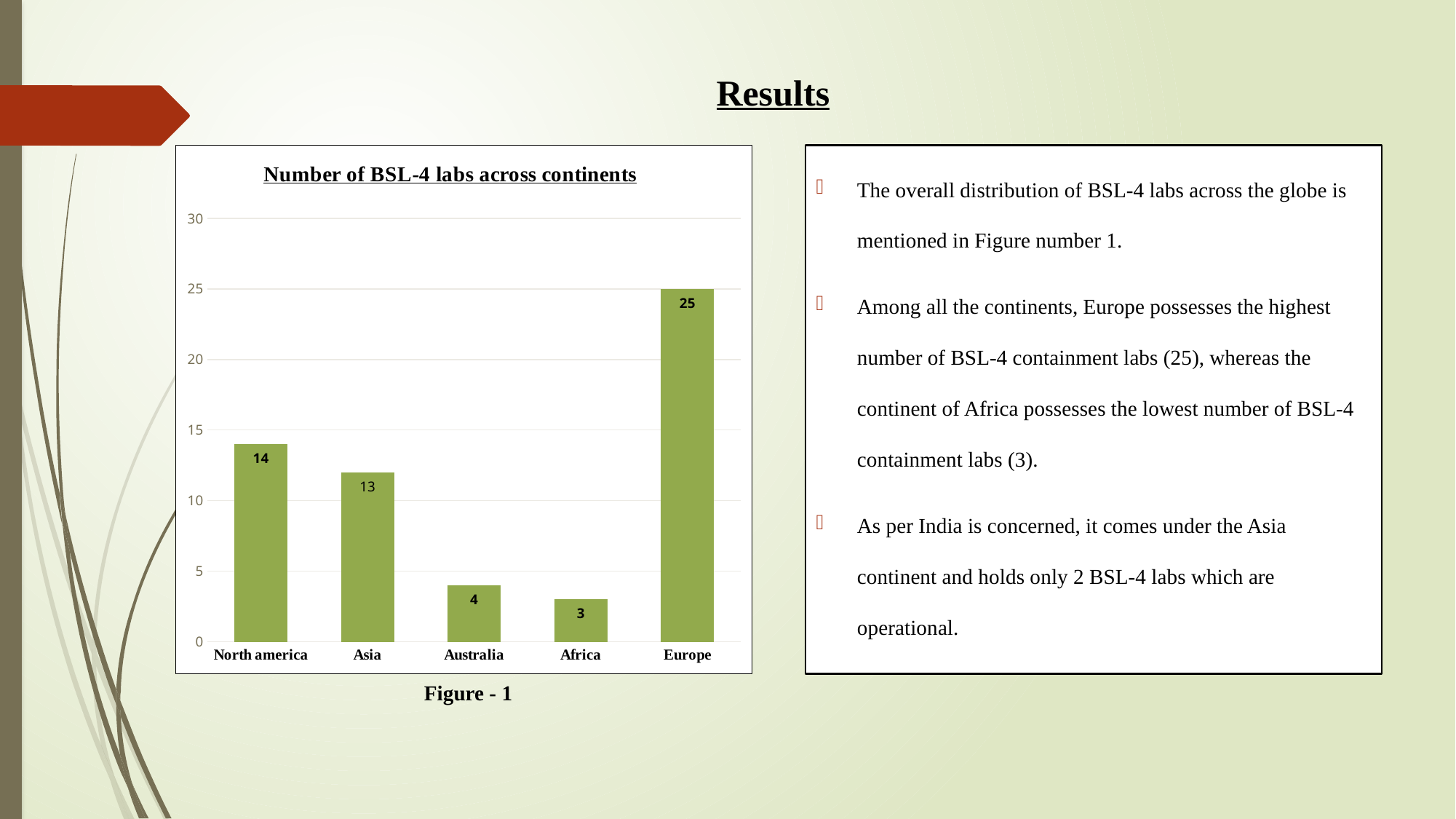
Which continent has the highest number of BSL-4 labs? Europe What is the number of BSL-4 labs in North america? 14 Which has more BSL-4 labs, North america or Asia? North america What kind of chart is shown on the slide? Bar chart What is the difference between the number of BSL-4 labs in Australia and in Africa? 1 What is the number of BSL-4 labs in Europe? 25 Which continent has the lowest number of BSL-4 labs? Africa What is the difference between the number of BSL-4 labs in Europe and in North america? 11 What is the number of BSL-4 labs in Asia? 13 How many continents are shown in the chart? 5 Is the value for Europe greater or less than 20? greater What is the number of BSL-4 labs in Australia? 4